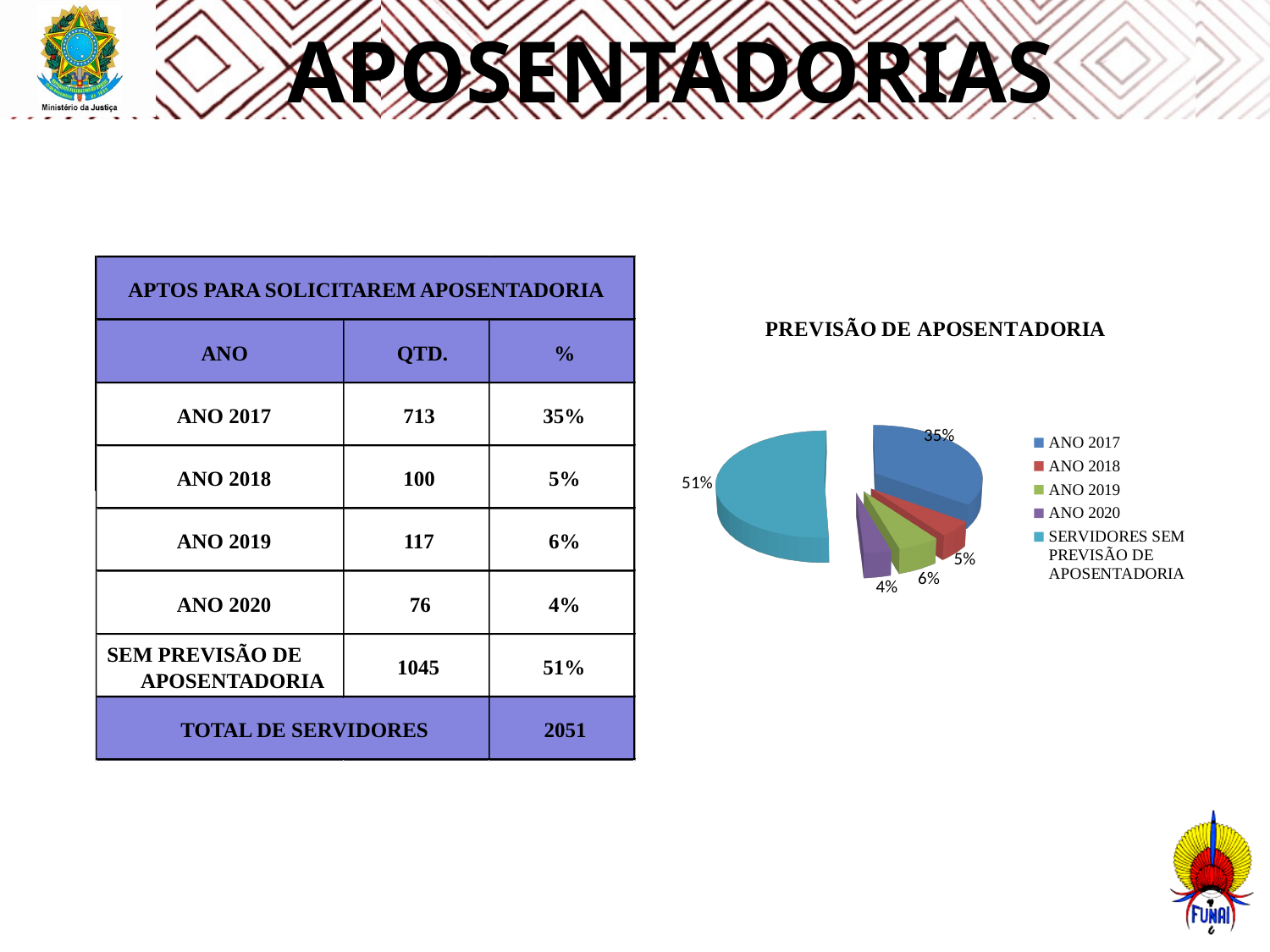
What share of the pie does ANO 2017 represent? 35% What is the difference in percentage points between the ANO 2017 slice and the ANO 2018 slice? 30 How many slices does the pie chart have? 5 Which slice of the pie chart is the largest? SERVIDORES SEM PREVISÃO DE APOSENTADORIA What is the title of the chart? PREVISÃO DE APOSENTADORIA Which slice of the pie chart is the smallest? ANO 2020 What share of the pie does ANO 2020 represent? 4% Which is larger in the pie chart, ANO 2019 or ANO 2020? ANO 2019 What share of the pie does ANO 2018 represent? 5% What kind of chart is shown on the slide? Pie chart